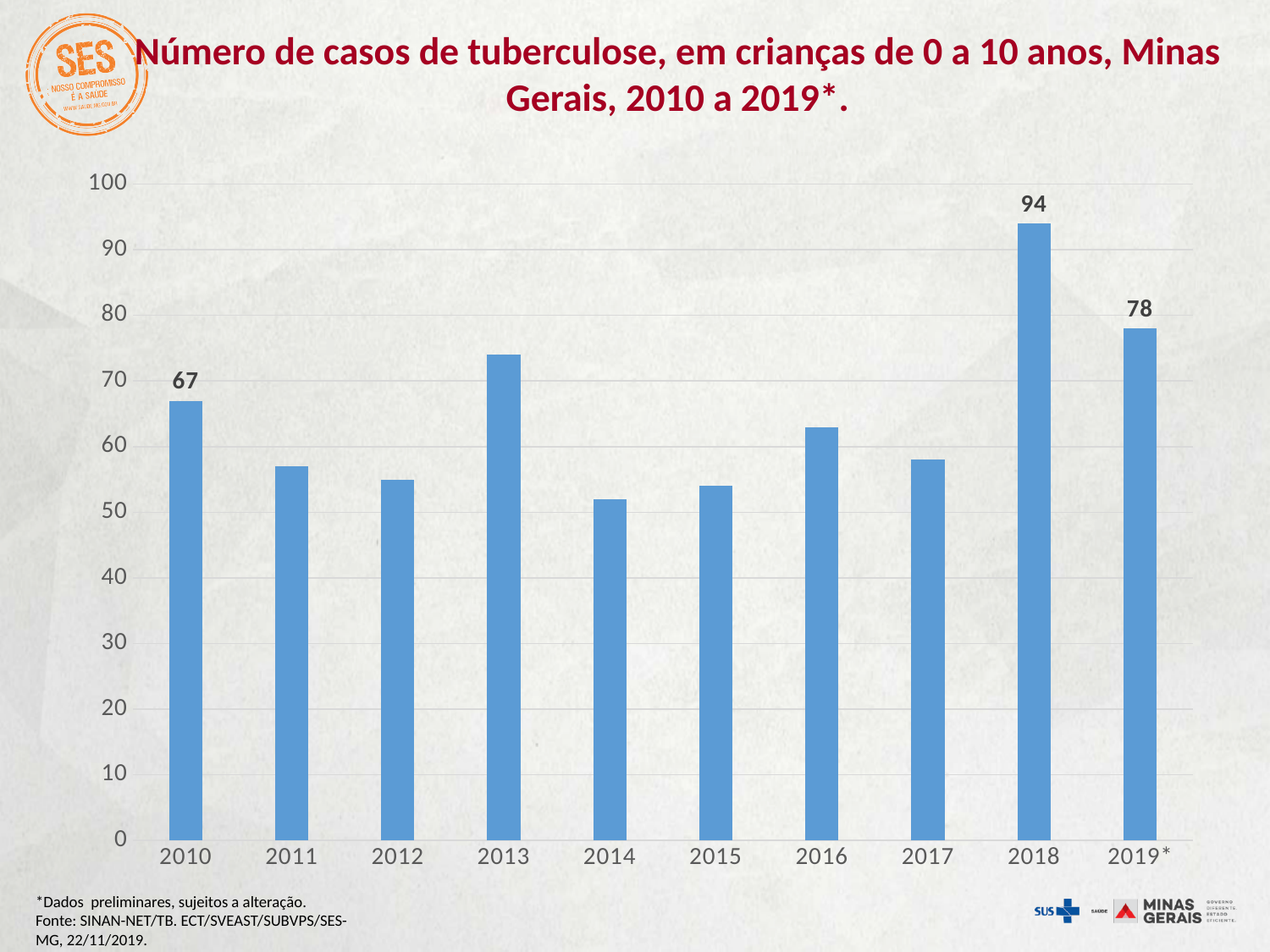
What is the number of tuberculosis cases in 2019*? 78 What is the number of tuberculosis cases in 2018? 94 Which year has the highest number of cases? 2018 Which year has more cases, 2010 or 2019*? 2019* What kind of chart is shown on the slide? Bar chart Do the values rise or fall from 2018 to 2019*? Fall What is the difference between the number of cases in 2018 and in 2010? 27 How many years are shown on the x axis? 10 Is the value for 2014 greater or less than 60? less Is the value for 2013 greater or less than 70? greater What is the number of tuberculosis cases in 2010? 67 What is the difference between the number of cases in 2018 and in 2019*? 16